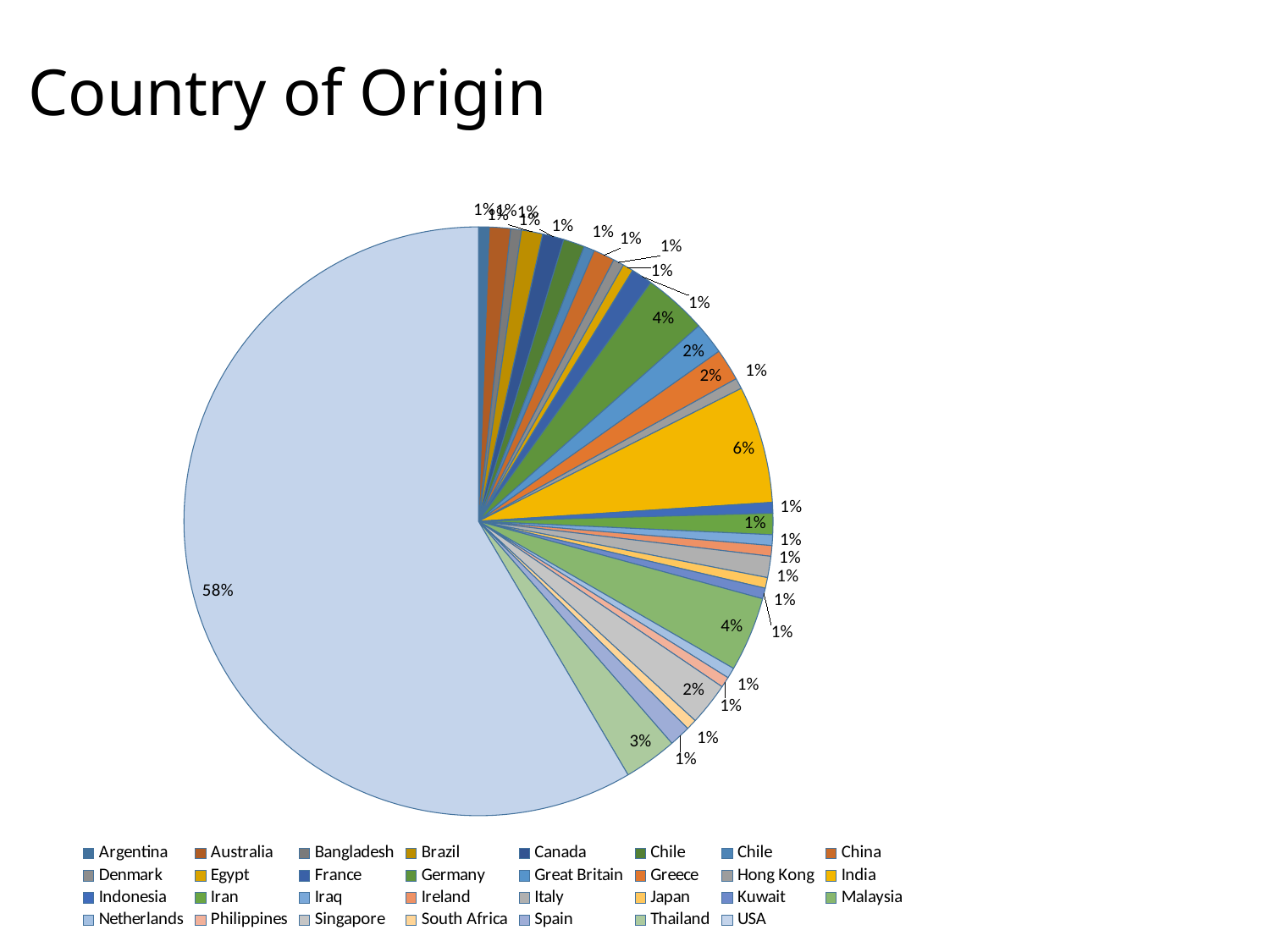
What is the title of the chart? Country of Origin Which country name appears twice in the legend? Chile How many countries are listed in the legend? 31 Which is larger, the share for USA or the share for India? USA What is the value shown for Germany? 4% What kind of chart is shown on the slide? pie chart Which is larger, the share for Germany or the share for Thailand? Germany Which country has the largest share of the pie? USA What is the value shown for Thailand? 3% What is the difference between the USA share and the India share? 52% What share of the pie does USA account for? 58% What is the value shown for India? 6%